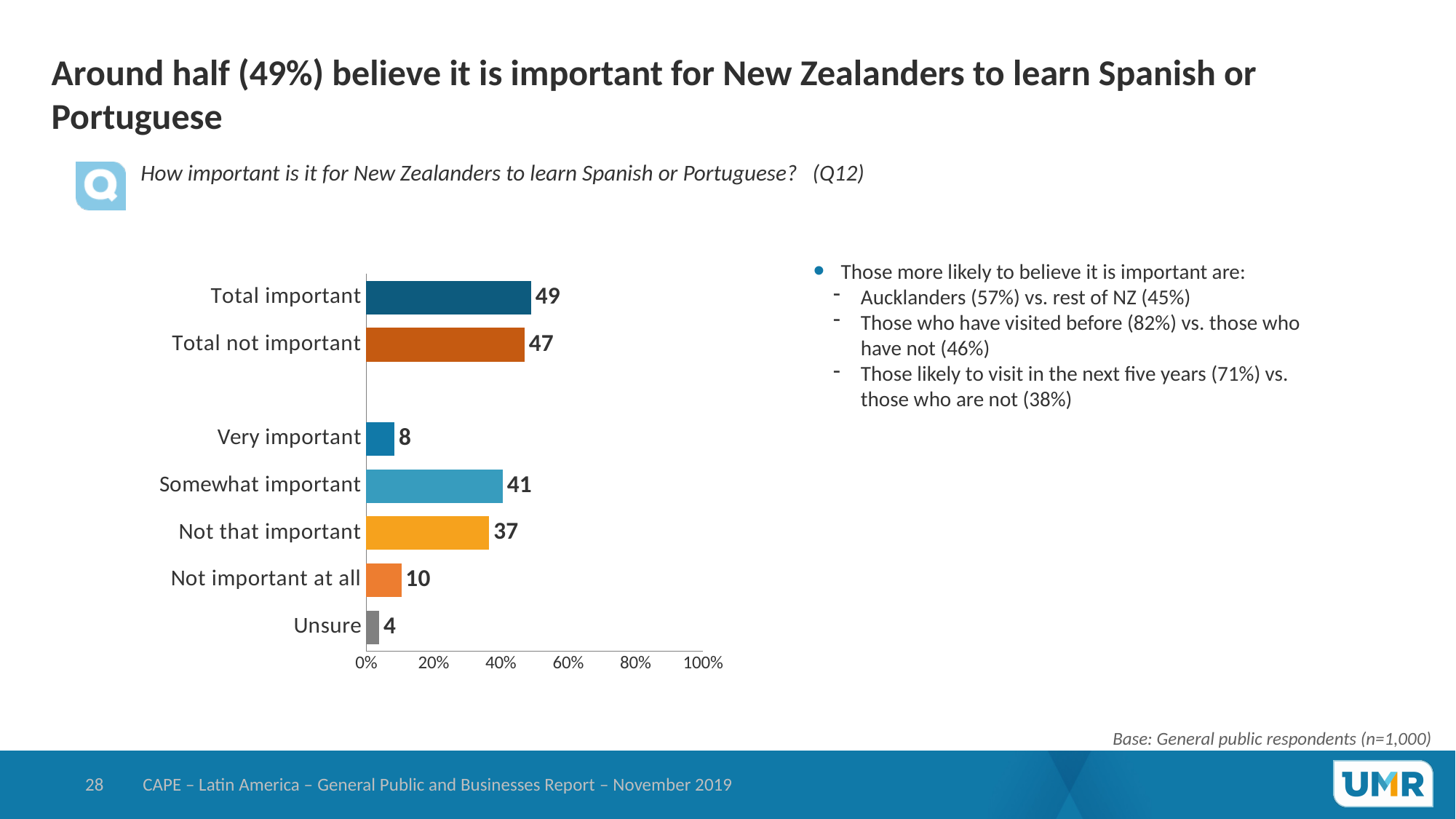
What is the difference between Total important and Total not important? 2 Which category has the highest value? Total important What is the difference between Somewhat important and Not that important? 4 Which category has the lowest value? Unsure What is the value for Not important at all? 10 What is the value for Total important? 49 Which is larger, Very important or Not important at all? Not important at all Is the value for Not that important greater or less than 40%? less What kind of chart is shown on the slide? Bar chart How many categories are shown on the chart? 7 What is the value for Unsure? 4 What is the value for Somewhat important? 41